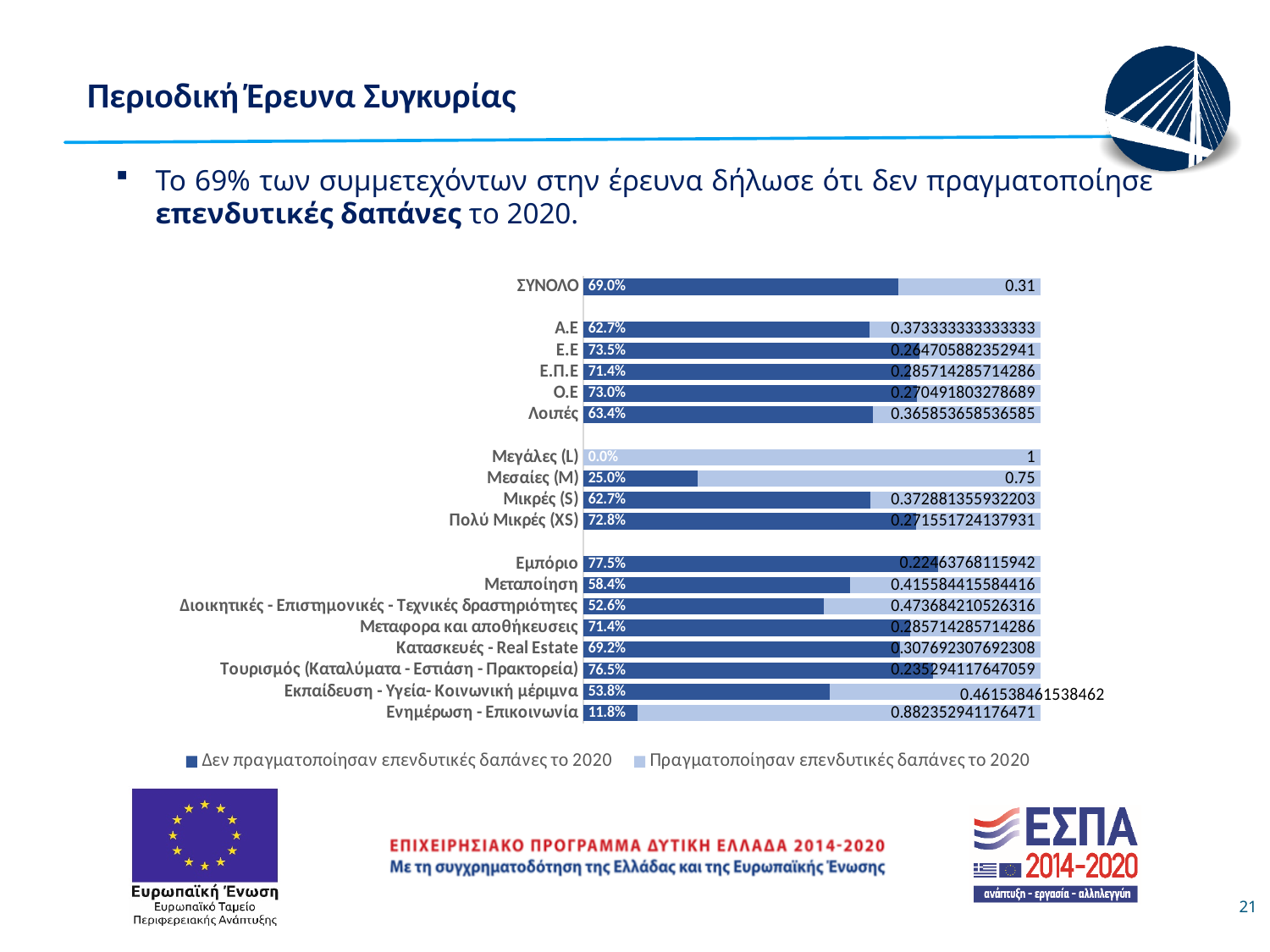
What is the value for Εμπόριο in the series Δεν πραγματοποίησαν επενδυτικές δαπάνες το 2020? 77.5% How many series does the legend list? 2 What is the difference in percentage points between Ε.Ε and Α.Ε in the series Δεν πραγματοποίησαν επενδυτικές δαπάνες το 2020? 10.8 What percentage of ΣΥΝΟΛΟ did not make investment expenditures in 2020 (Δεν πραγματοποίησαν επενδυτικές δαπάνες το 2020)? 69.0% Which category has the lowest value in the series Δεν πραγματοποίησαν επενδυτικές δαπάνες το 2020? Μεγάλες (L) Which has a larger value in the series Δεν πραγματοποίησαν επενδυτικές δαπάνες το 2020: Μεταποίηση or Διοικητικές - Επιστημονικές - Τεχνικές δραστηριότητες? Μεταποίηση How many categories are shown on the chart? 18 What kind of chart is shown on the slide? Stacked bar chart What value is printed for Μεγάλες (L) in the series Πραγματοποίησαν επενδυτικές δαπάνες το 2020? 1 Which category has the highest value in the series Δεν πραγματοποίησαν επενδυτικές δαπάνες το 2020? Εμπόριο What is the value for Ενημέρωση - Επικοινωνία in the series Δεν πραγματοποίησαν επενδυτικές δαπάνες το 2020? 11.8% What value is printed for Μεσαίες (M) in the series Πραγματοποίησαν επενδυτικές δαπάνες το 2020? 0.75